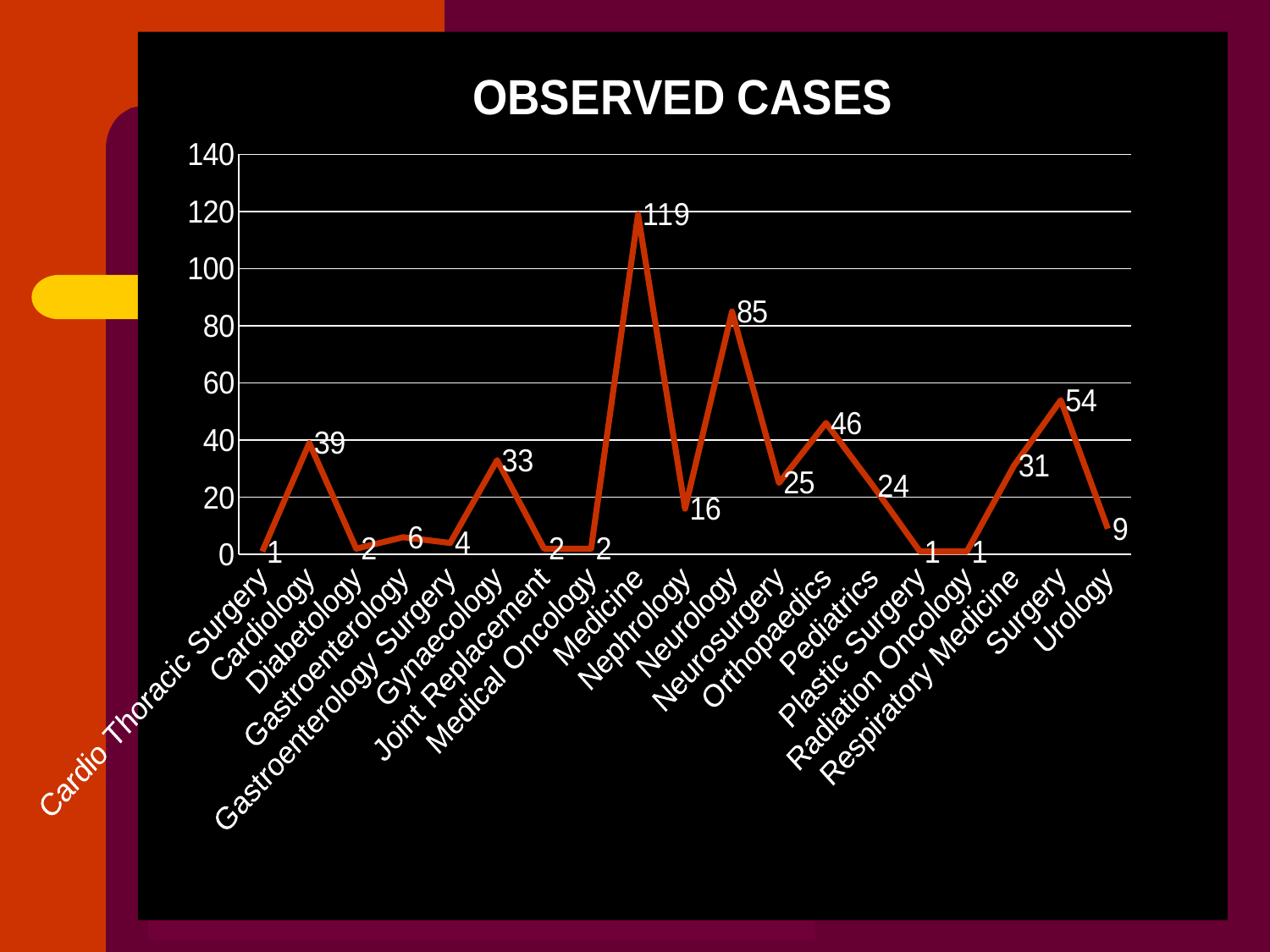
What is the difference between the values for Surgery and Orthopaedics? 8 What is the value for Respiratory Medicine? 31 How many categories are plotted on the x axis? 19 Is the value for Neurosurgery greater or less than 40? less What is the value for Gynaecology? 33 What is the value for Neurology? 85 What is the value for Medicine? 119 What kind of chart is shown on the slide? line chart Which category has the highest value? Medicine Which is larger, the value for Cardiology or the value for Pediatrics? Cardiology What is the title of the chart? OBSERVED CASES What is the difference between the values for Medicine and Neurology? 34